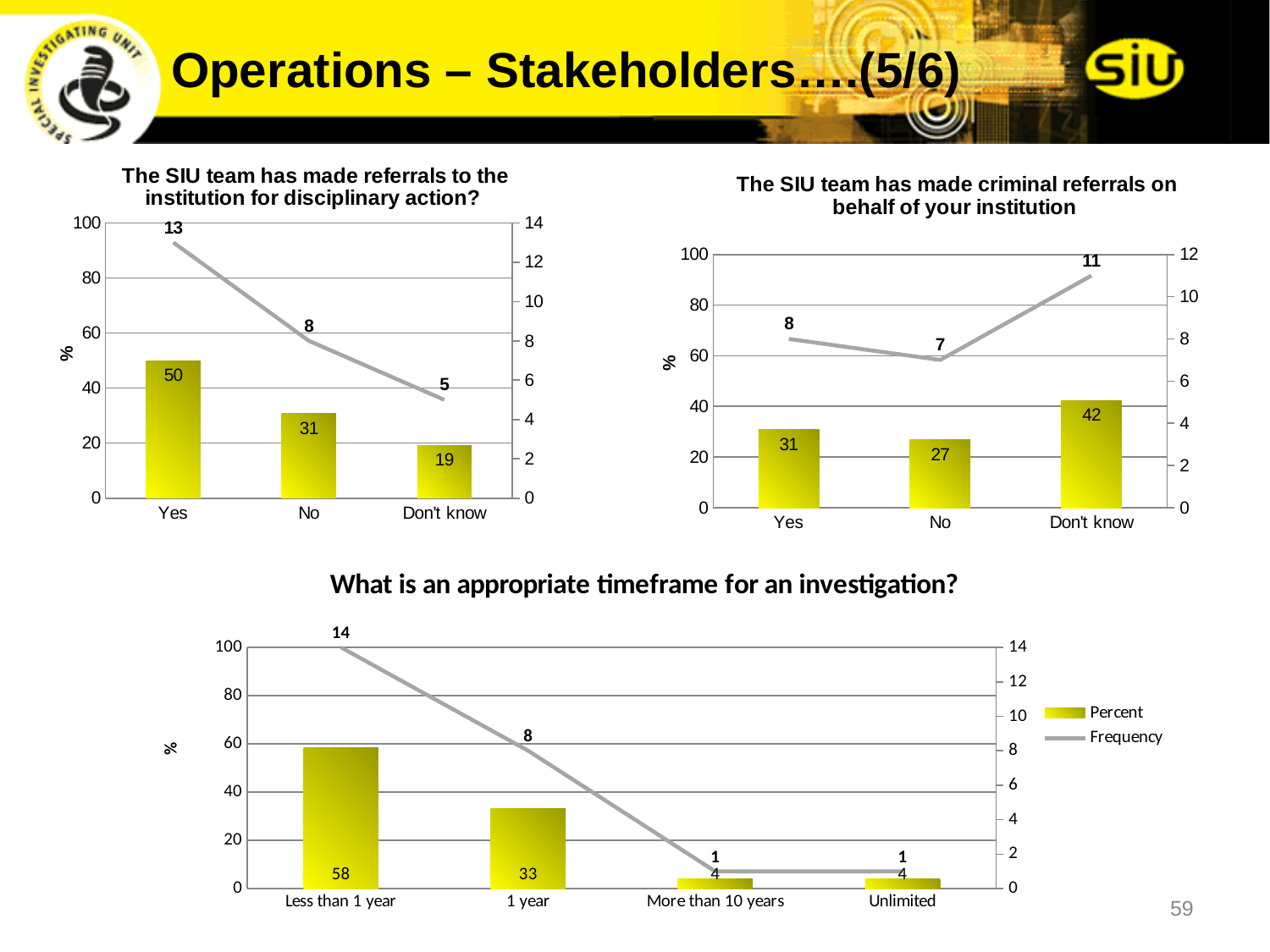
In the chart 'The SIU team has made criminal referrals on behalf of your institution', which category has the highest percent bar? Don't know In the chart 'The SIU team has made criminal referrals on behalf of your institution', is the percent value for 'Yes' larger or smaller than the percent value for 'No'? larger In the chart 'The SIU team has made referrals to the institution for disciplinary action?', what is the difference between the percent values for 'Yes' and 'No'? 19 In the chart 'What is an appropriate timeframe for an investigation?', what is the percent value for '1 year'? 33 In the chart 'What is an appropriate timeframe for an investigation?', what is the frequency value for 'Less than 1 year'? 14 In the chart 'The SIU team has made criminal referrals on behalf of your institution', what is the frequency value for 'No'? 7 How many series does the legend of the chart 'What is an appropriate timeframe for an investigation?' list? 2 In the chart 'The SIU team has made referrals to the institution for disciplinary action?', what is the frequency value for 'Don't know'? 5 In the chart 'The SIU team has made referrals to the institution for disciplinary action?', what is the percent value for 'Yes'? 50 How many categories are shown on the x axis of the chart 'What is an appropriate timeframe for an investigation?'? 4 In the chart 'The SIU team has made referrals to the institution for disciplinary action?', which category has the lowest percent bar? Don't know In the chart 'The SIU team has made criminal referrals on behalf of your institution', what is the percent value for 'Don't know'? 42